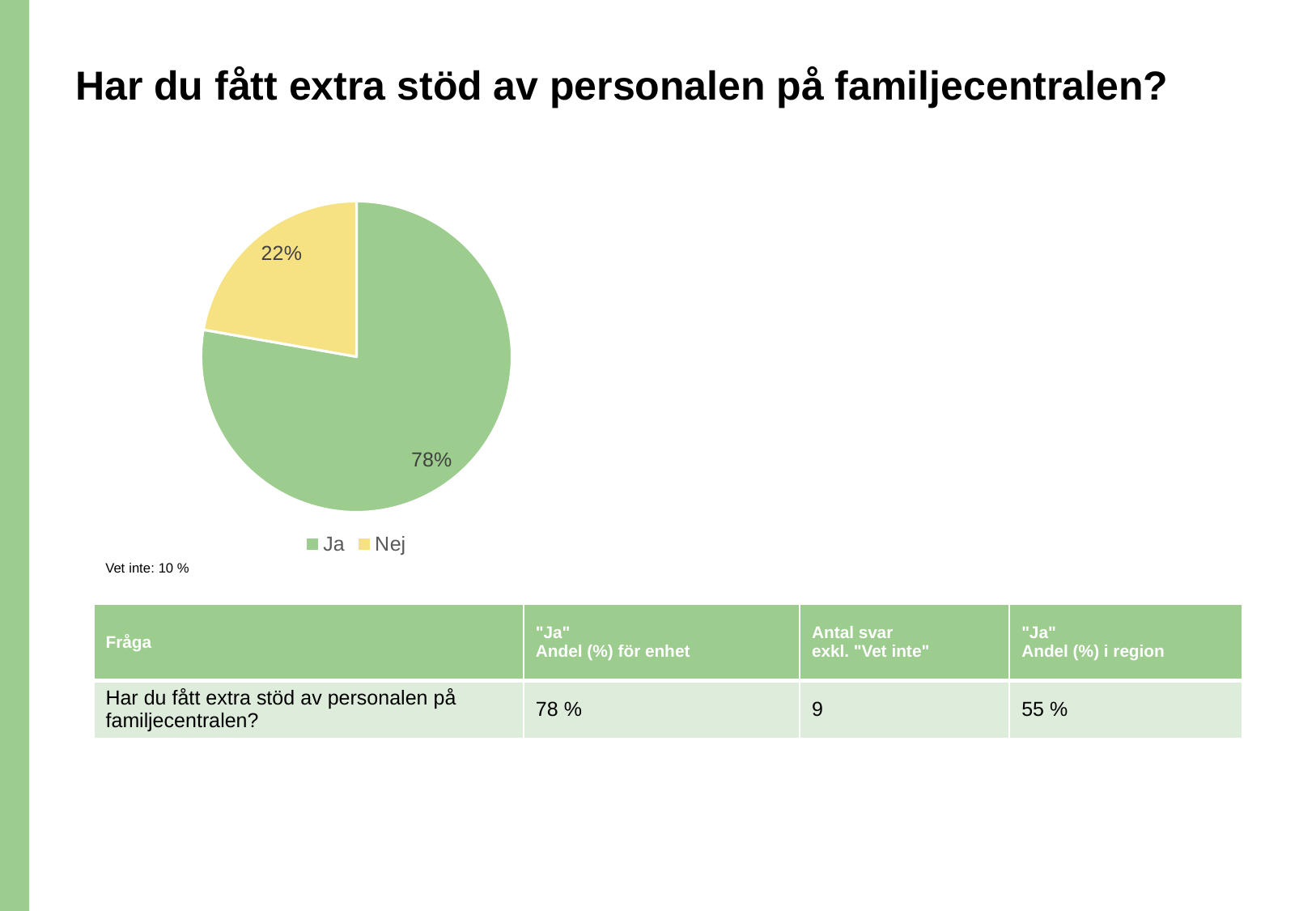
What share of the pie does the "Ja" slice represent? 78% Which slice of the pie is the largest? Ja How many entries does the legend list? 2 Which slice of the pie is the smallest? Nej What share of the pie does the "Nej" slice represent? 22% How many slices does the pie chart have? 2 What kind of chart is shown on the slide? Pie chart Which is larger, the "Ja" slice or the "Nej" slice? Ja What colour is the "Nej" slice in the pie chart? Yellow What percentage is given for "Vet inte" below the chart? 10 % What is the difference in percentage points between the "Ja" and "Nej" slices? 56